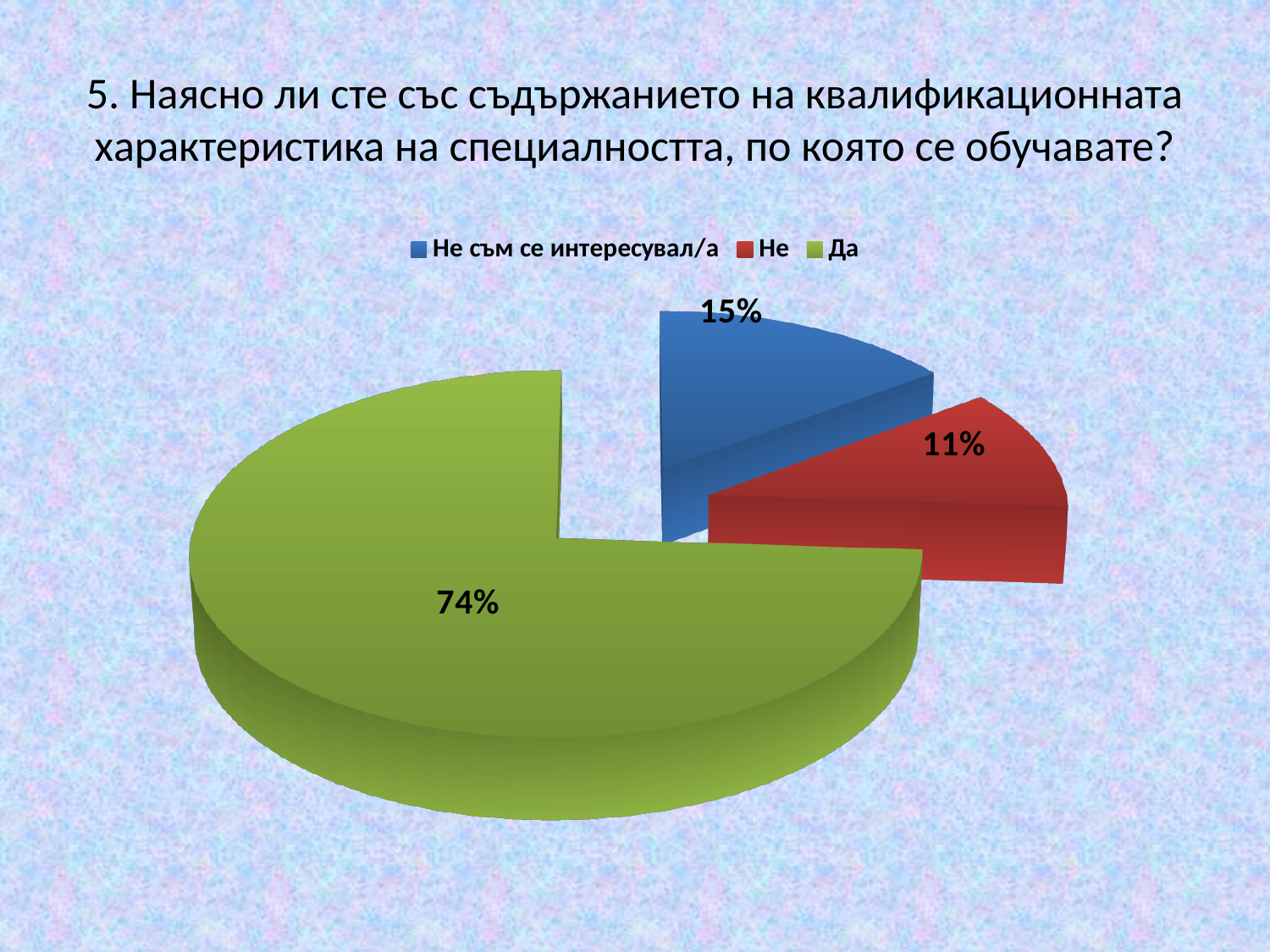
Which category has the largest share of the pie? Да What kind of chart is shown on the slide? pie chart What is the difference in percentage points between "Да" and "Не съм се интересувал/а"? 59 What percentage of the pie is labelled "Не"? 11% How many entries does the legend list? 3 What is the difference in percentage points between "Не съм се интересувал/а" and "Не"? 4 Which is larger, the share for "Не съм се интересувал/а" or the share for "Не"? Не съм се интересувал/а What colour is the slice for "Да"? green How many slices does the pie chart have? 3 Which category has the smallest share of the pie? Не What percentage of the pie is labelled "Не съм се интересувал/а"? 15% What percentage of the pie is labelled "Да"? 74%